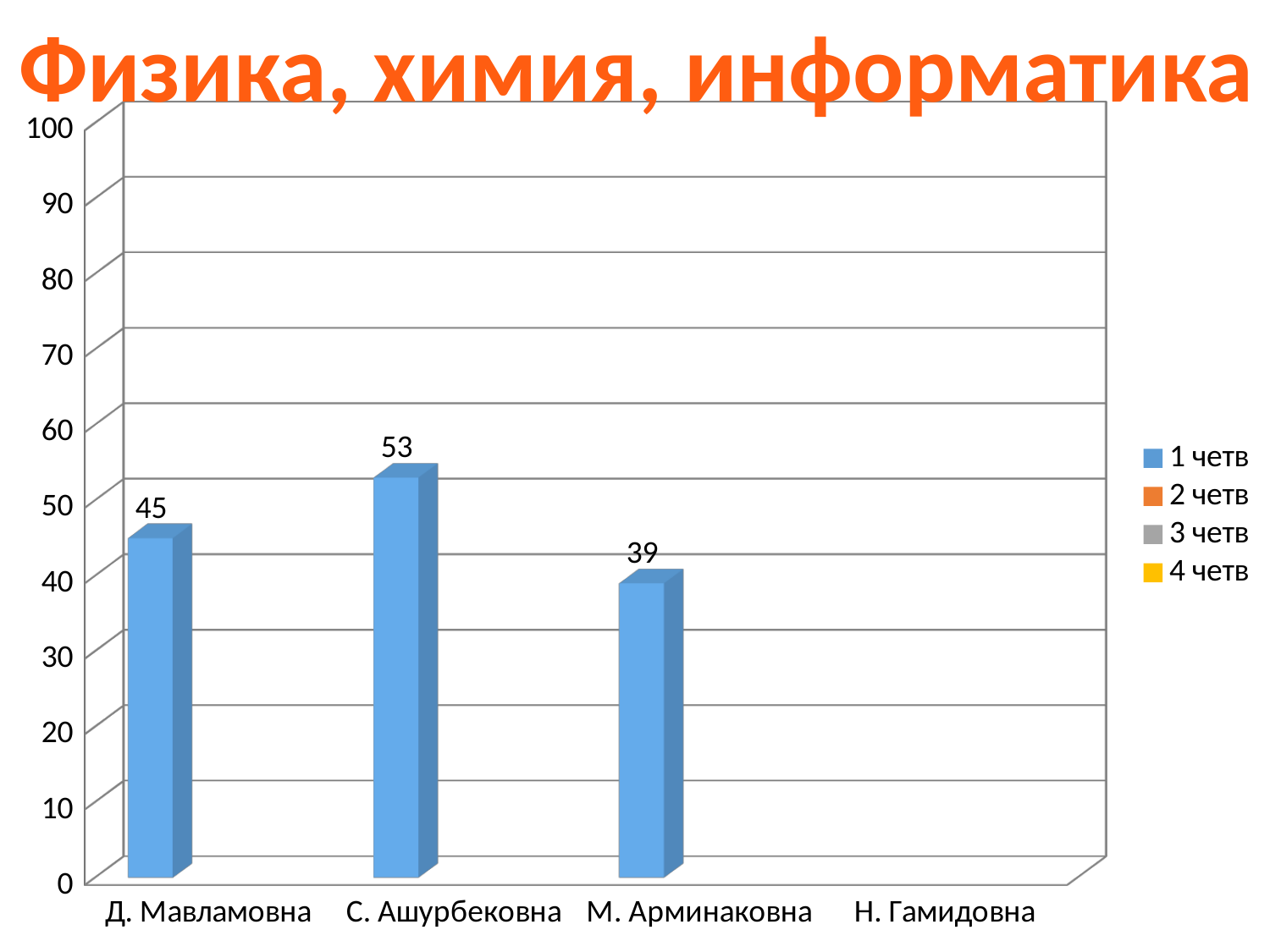
What is the value for М. Арминаковна in the 1 четв series? 39 What is the difference between the values for С. Ашурбековна and Д. Мавламовна? 8 What is the value for С. Ашурбековна in the 1 четв series? 53 Which is larger, the value for Д. Мавламовна or the value for М. Арминаковна? Д. Мавламовна Which category has the lowest value among the plotted bars? М. Арминаковна How many series does the legend list? 4 What kind of chart is shown on the slide? Bar chart How many categories are shown on the x axis? 4 What is the difference between the values for Д. Мавламовна and М. Арминаковна? 6 Is the value for С. Ашурбековна greater or less than 50? greater What is the value for Д. Мавламовна in the 1 четв series? 45 Which category has the highest value among the plotted bars? С. Ашурбековна